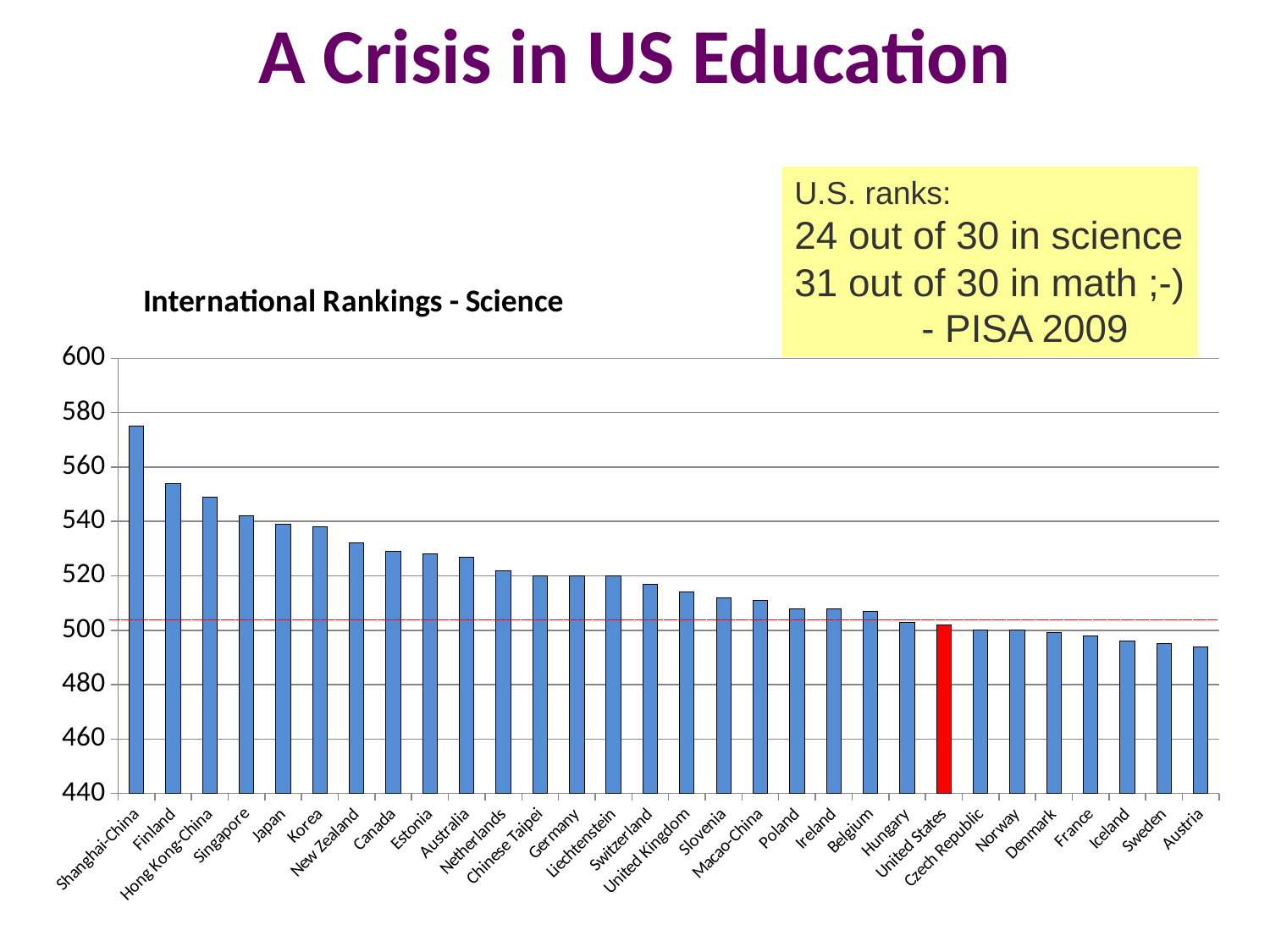
Which country's bar is highlighted in red? United States How many countries are shown in the chart? 30 What is the title of the chart? International Rankings - Science Do the bar values rise or fall from left to right along the x axis? fall Is the value for Shanghai-China greater or less than 560? greater Which country has the highest science score in the chart? Shanghai-China What kind of chart is shown on the slide? bar chart Is the value for Austria greater or less than 500? less Is the value for Finland greater or less than 540? greater Which country has the lowest science score in the chart? Austria Which has the larger value, Finland or Singapore? Finland